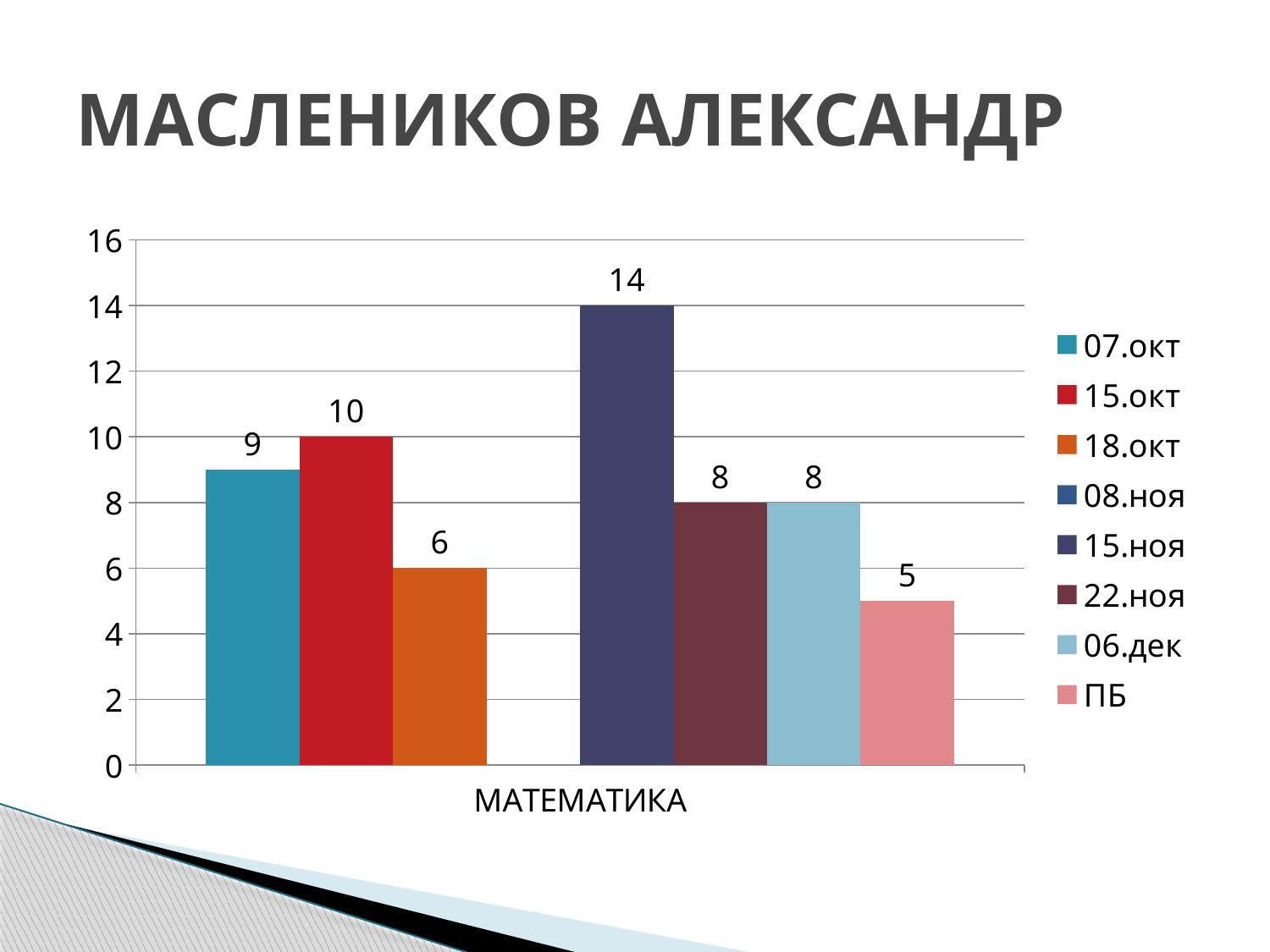
What is the value for 07.окт in МАТЕМАТИКА? 9 Is the value for 15.ноя greater or less than 12? greater What kind of chart is shown on the slide? bar chart What is the title of the slide? МАСЛЕНИКОВ АЛЕКСАНДР Which series has the highest value in МАТЕМАТИКА? 15.ноя Which series has the lowest labelled value in МАТЕМАТИКА? ПБ Which is larger, the value for 15.окт or the value for 18.окт? 15.окт What is the difference between the values for 15.ноя and 15.окт? 4 What is the value for 18.окт in МАТЕМАТИКА? 6 How many series does the legend list? 8 What is the value for ПБ in МАТЕМАТИКА? 5 What is the value for 15.ноя in МАТЕМАТИКА? 14